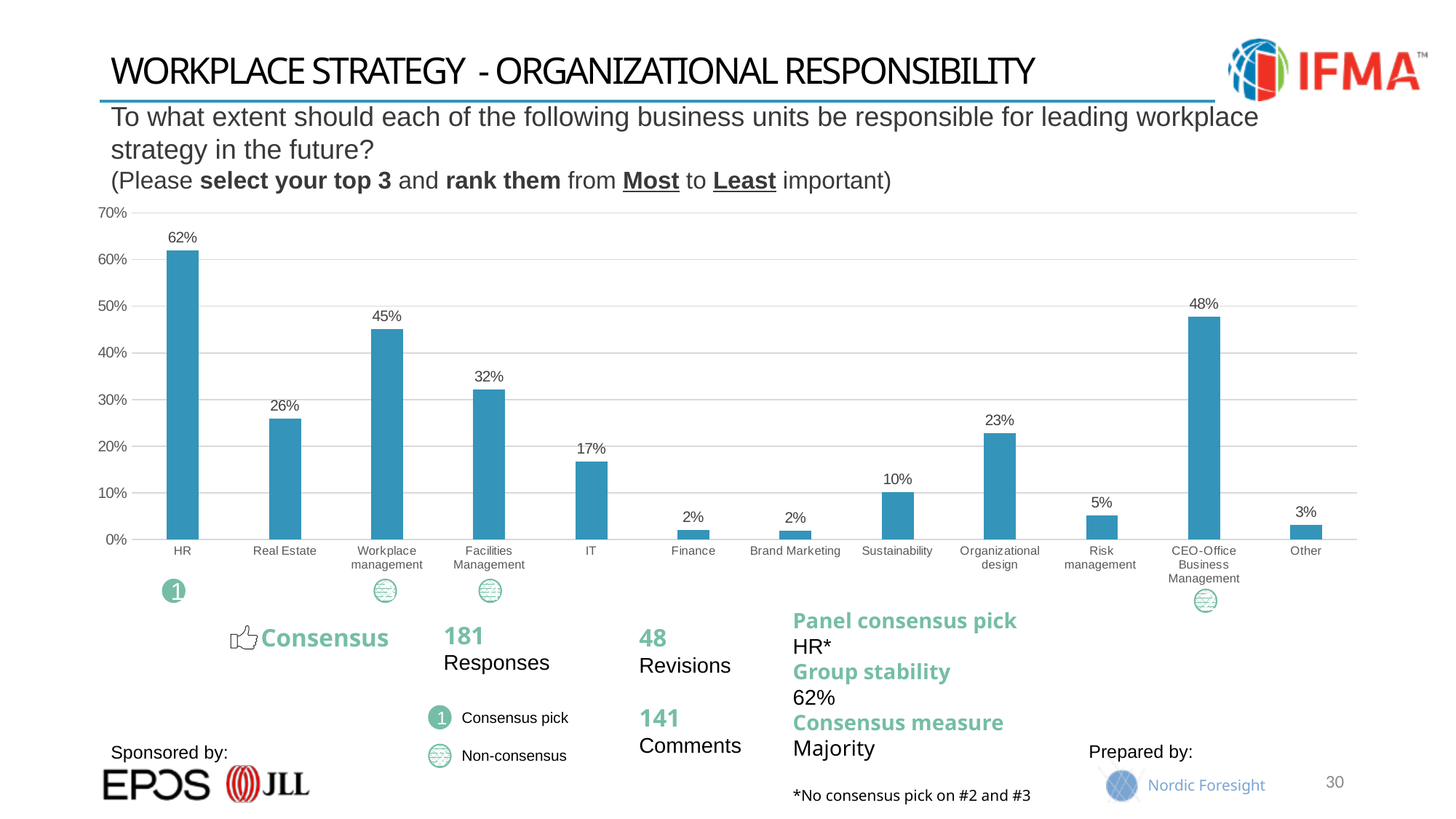
What is the difference between the values for HR and Workplace management? 17% How many categories are shown on the x axis? 12 What is the value for Risk management? 5% Which category is marked with the consensus pick symbol below the chart? HR Which is larger, the value for Facilities Management or the value for Real Estate? Facilities Management Is the value for IT greater or less than 20%? less What is the value for HR? 62% What is the value for CEO-Office Business Management? 48% What kind of chart is shown on the slide? bar chart What is the difference between the values for CEO-Office Business Management and Sustainability? 38% What is the value for Organizational design? 23% Which category has the highest value? HR